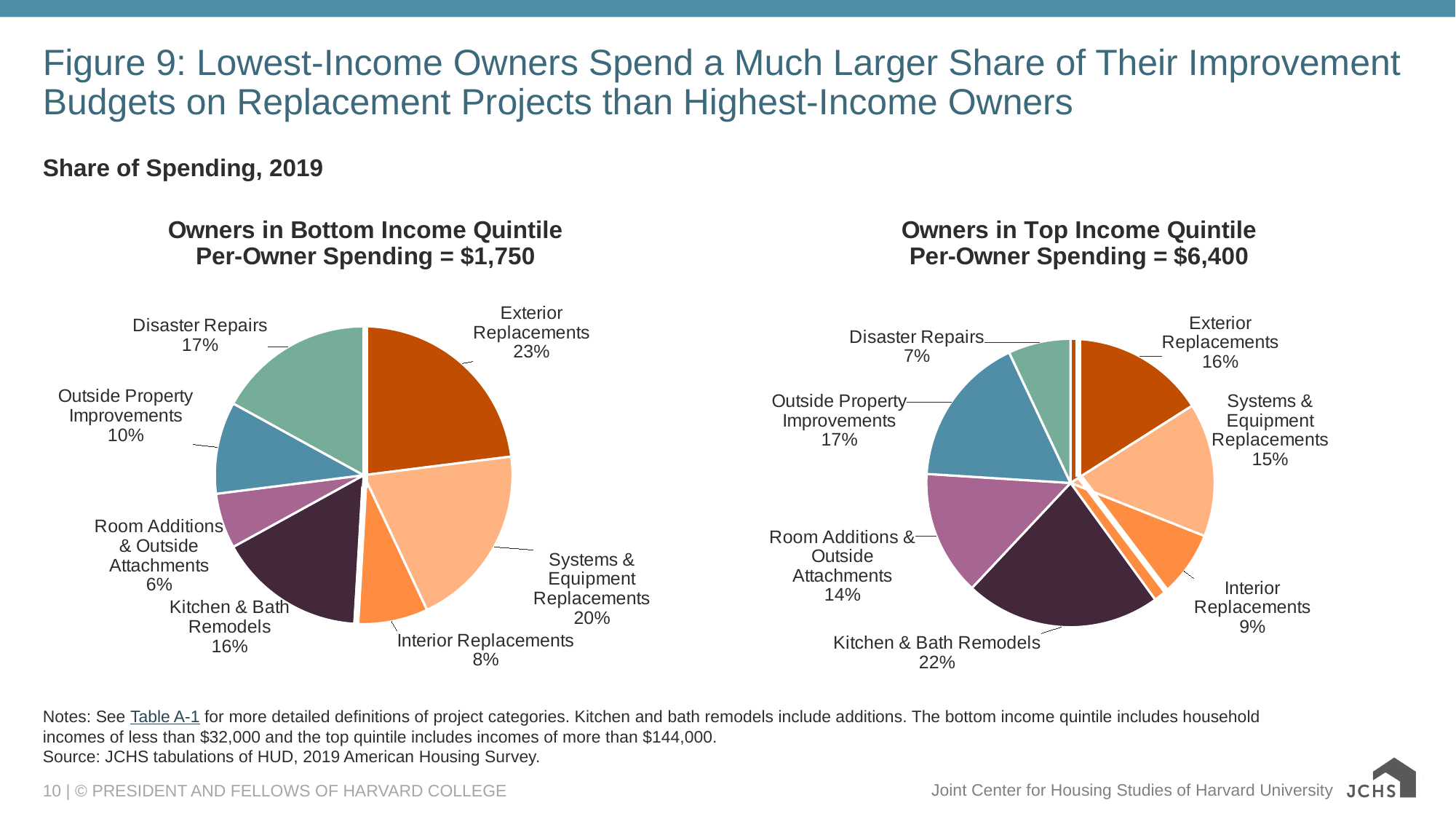
What is the per-owner spending stated in the title of the Owners in Bottom Income Quintile chart? $1,750 What kind of charts are shown on the slide? Pie charts In the Owners in Top Income Quintile chart, which category has the largest share of spending? Kitchen & Bath Remodels In the Owners in Bottom Income Quintile chart, which category has the largest share of spending? Exterior Replacements What is the per-owner spending stated in the title of the Owners in Top Income Quintile chart? $6,400 In the Owners in Top Income Quintile chart, what share of spending goes to Outside Property Improvements? 17% In the Owners in Bottom Income Quintile chart, which category has the smallest share of spending? Room Additions & Outside Attachments What is the difference in percentage points between the Disaster Repairs share in the Bottom Income Quintile chart and the Disaster Repairs share in the Top Income Quintile chart? 10 percentage points In the Owners in Top Income Quintile chart, which labeled category has the smallest share of spending? Disaster Repairs In the Owners in Bottom Income Quintile chart, what share of spending goes to Exterior Replacements? 23% In the Owners in Top Income Quintile chart, what share of spending goes to Kitchen & Bath Remodels? 22% Which is larger: the Systems & Equipment Replacements share in the Bottom Income Quintile chart or in the Top Income Quintile chart? Bottom Income Quintile